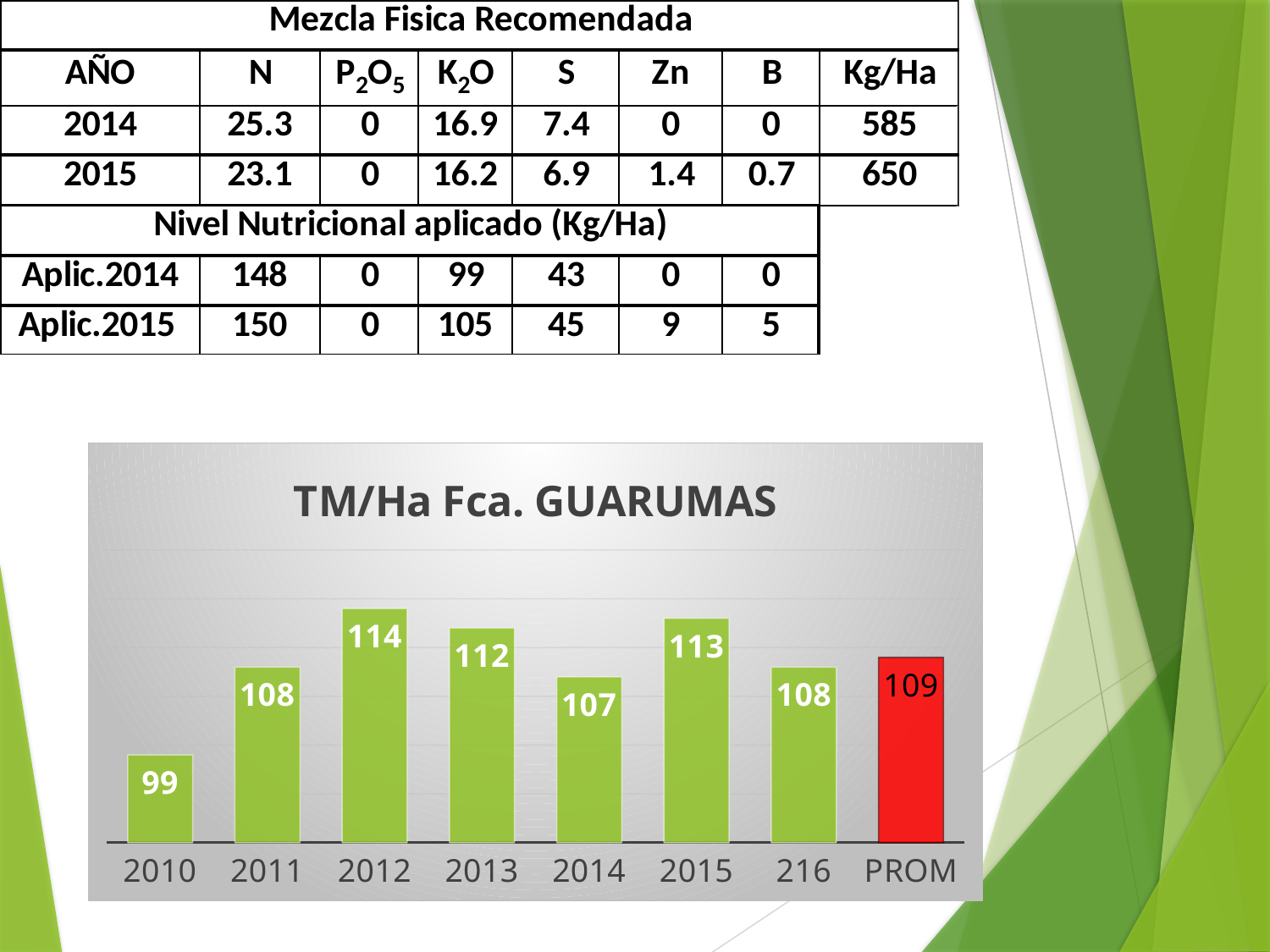
What is the value of the PROM bar in the TM/Ha Fca. GUARUMAS chart? 109 Which bar in the TM/Ha Fca. GUARUMAS chart is coloured red? PROM How many bars are shown in the TM/Ha Fca. GUARUMAS chart? 8 What is the difference between the values for 2012 and 2010 in the TM/Ha Fca. GUARUMAS chart? 15 What is the value for 2012 in the TM/Ha Fca. GUARUMAS chart? 114 In the TM/Ha Fca. GUARUMAS chart, which is larger, the value for 2013 or the value for 2014? 2013 Which category has the highest value in the TM/Ha Fca. GUARUMAS chart? 2012 What is the value for 2010 in the TM/Ha Fca. GUARUMAS chart? 99 What kind of chart is the TM/Ha Fca. GUARUMAS chart? Bar chart What is the difference between the values for 2015 and 2014 in the TM/Ha Fca. GUARUMAS chart? 6 What is the title of the chart on the slide? TM/Ha Fca. GUARUMAS Which category has the lowest value in the TM/Ha Fca. GUARUMAS chart? 2010